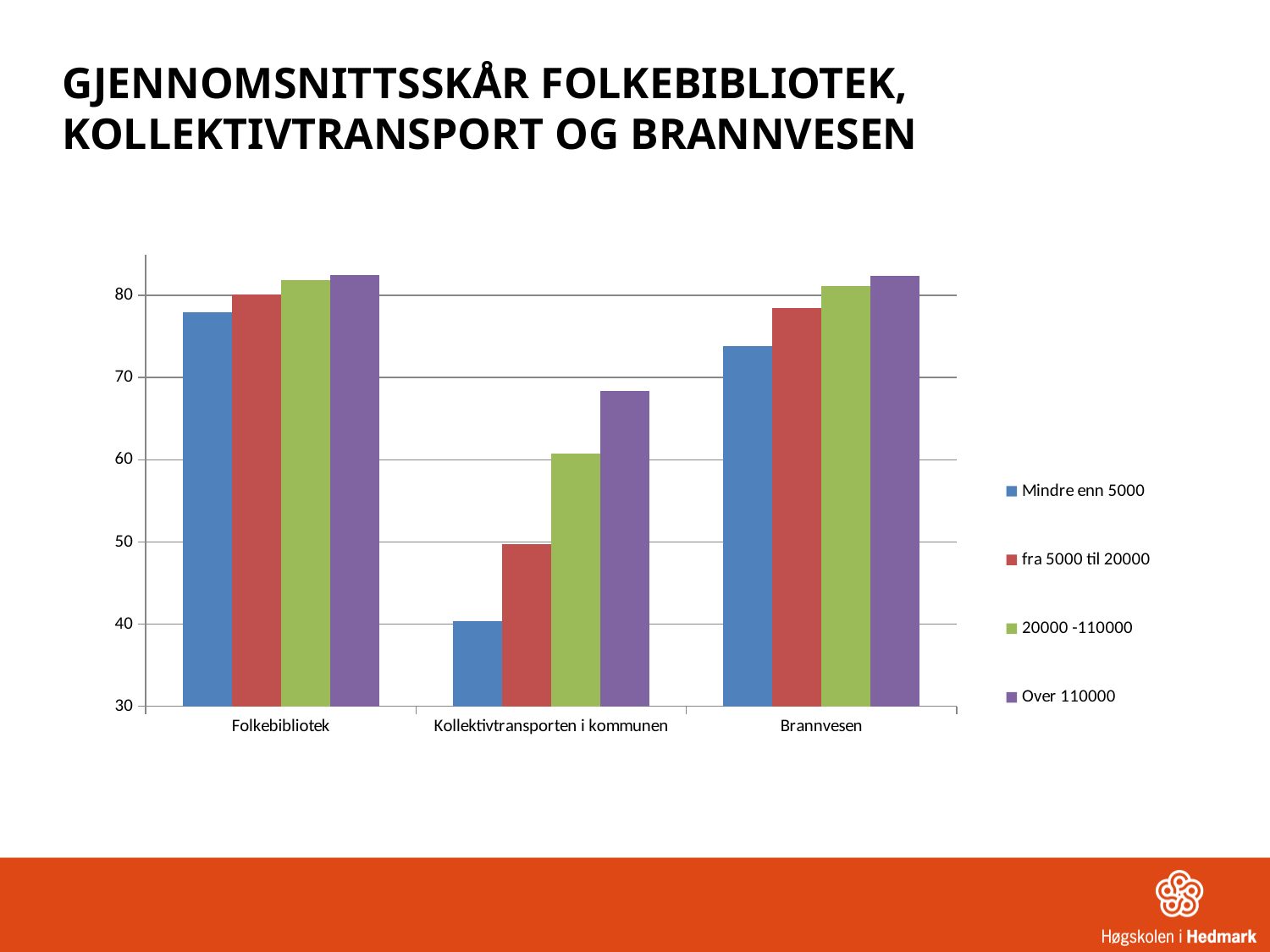
Which category has the lowest value in the Mindre enn 5000 series? Kollektivtransporten i kommunen For Kollektivtransporten i kommunen, which is larger: the value for 20000 -110000 or the value for fra 5000 til 20000? 20000 -110000 Is the value for Kollektivtransporten i kommunen in the Over 110000 series greater or less than 60? greater Is the value for Brannvesen in the Mindre enn 5000 series greater or less than 70? greater Which legend entry is shown in purple? Over 110000 How many series does the chart's legend list? 4 How many categories are shown on the x axis of the chart? 3 What kind of chart is shown on the slide? bar chart In the Mindre enn 5000 series, which is larger: the value for Folkebibliotek or the value for Brannvesen? Folkebibliotek Which category has the lowest value in the Over 110000 series? Kollektivtransporten i kommunen Is the value for Kollektivtransporten i kommunen in the Mindre enn 5000 series greater or less than 50? less